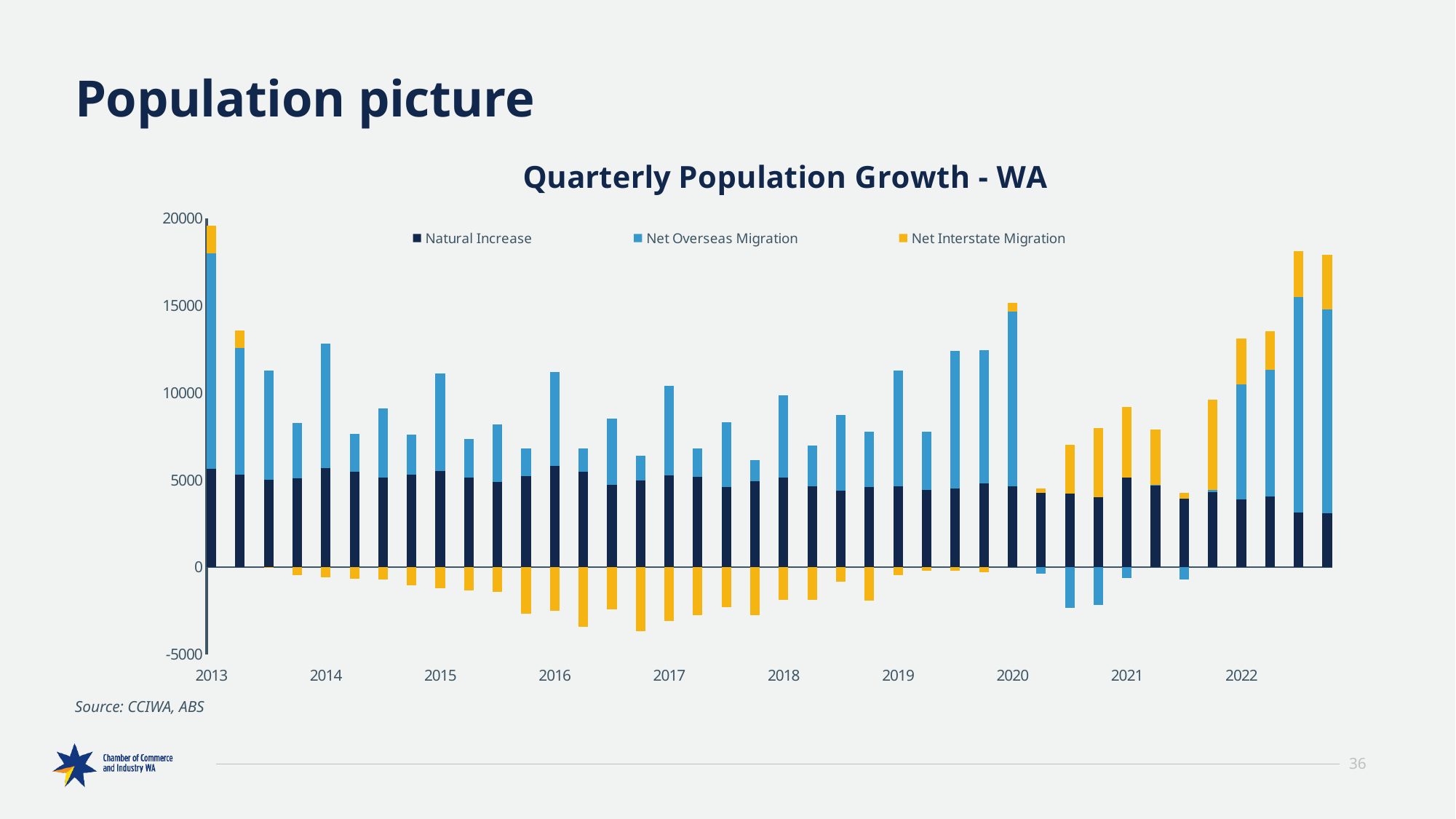
How many series does the legend of the Quarterly Population Growth - WA chart list? 3 What type of chart is shown on the slide? Stacked bar chart Is the Net Interstate Migration value for the quarter at the 2022 label positive or negative? Positive How many year labels are shown on the x axis of the chart? 10 What is the title of the chart on the slide? Quarterly Population Growth - WA Is the total stacked height of the first 2013 bar greater or less than 15000? greater Is the Net Interstate Migration value for the quarter just before the 2017 label greater or less than 0? less Does the Natural Increase series generally rise or fall from 2013 to 2022? Fall Which colour represents Net Interstate Migration in the chart? Yellow Which is larger: the Natural Increase value in the first quarter of 2013 or in the last quarter shown in 2022? First quarter of 2013